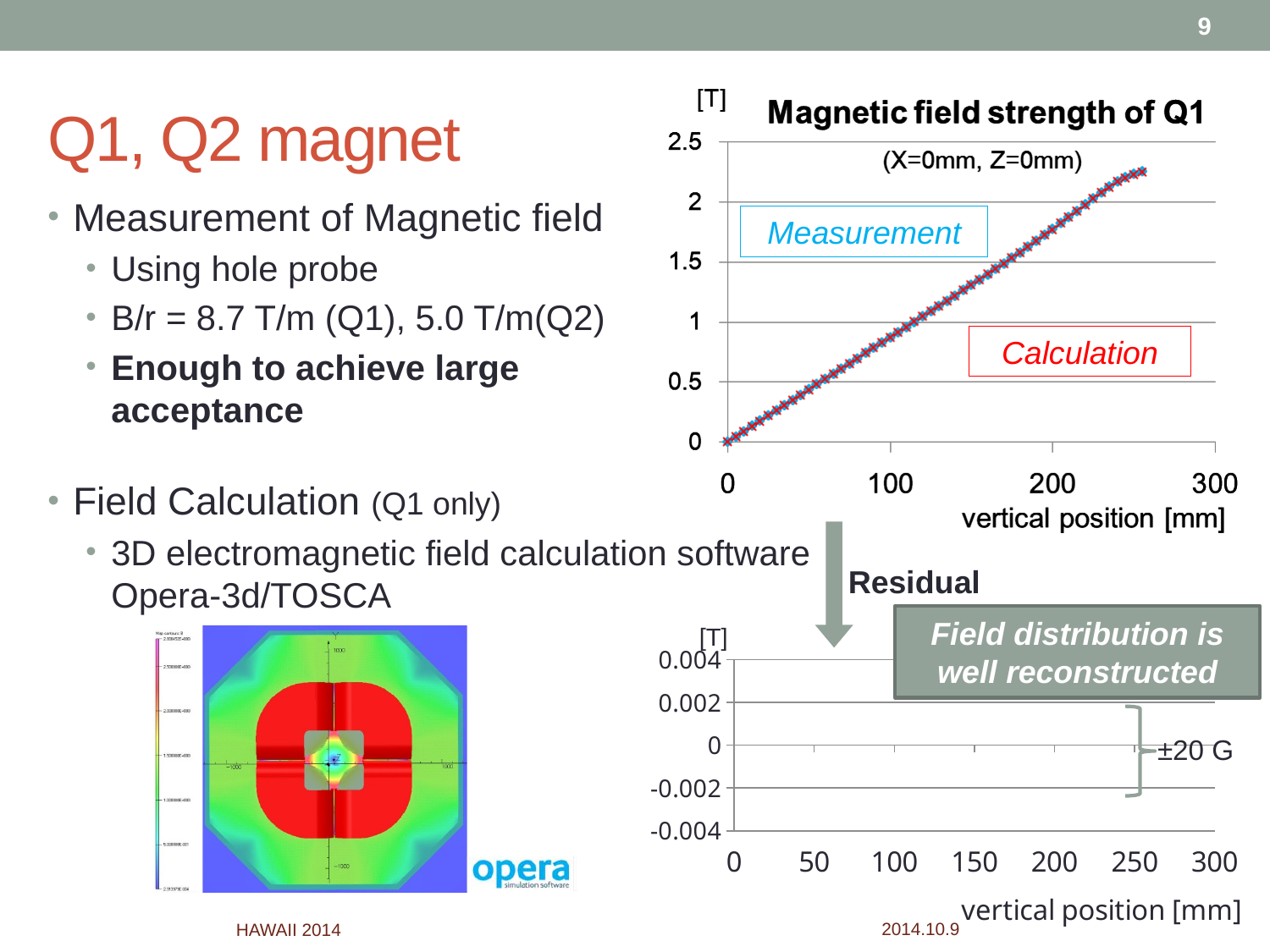
In the chart titled "Magnetic field strength of Q1", what is the highest value shown on the y axis? 2.5 In the Residual chart at the bottom right, what is the highest value shown on the x axis? 300 In the Residual chart at the bottom right, what residual range is annotated next to the bracket? ±20 G In the chart titled "Magnetic field strength of Q1", do the values rise or fall as vertical position increases? rise In the chart titled "Magnetic field strength of Q1", is the field value at a vertical position of 100 mm greater or less than 1 T? less In the chart titled "Magnetic field strength of Q1", is the field value at a vertical position of 200 mm greater or less than 1.5 T? greater In the chart titled "Magnetic field strength of Q1", is the field value at a vertical position of 250 mm greater or less than 2 T? greater In the chart titled "Magnetic field strength of Q1", how many data series are shown? 2